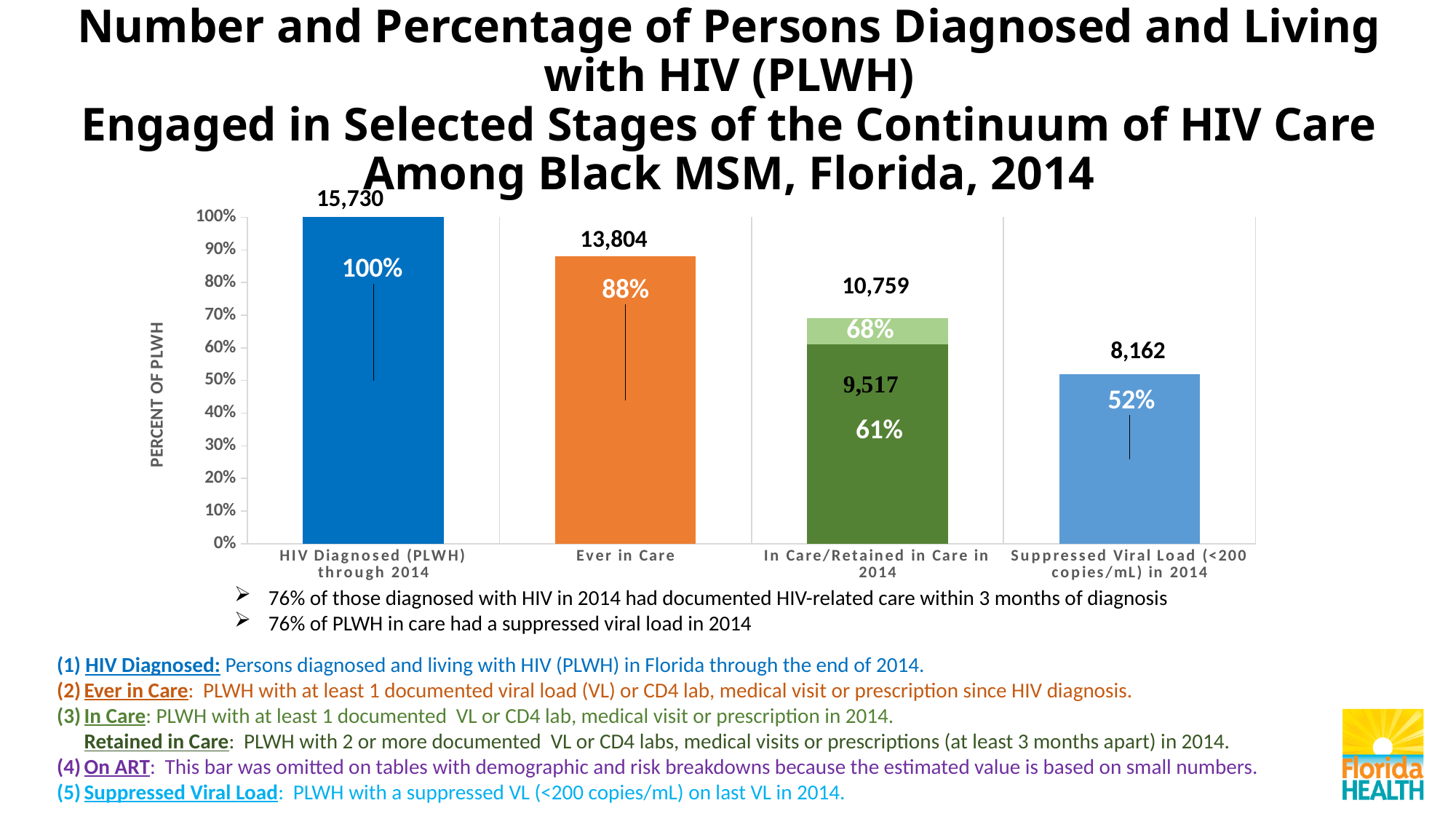
What number is labelled above the bar for HIV Diagnosed (PLWH) through 2014? 15,730 Do the bar values rise or fall from left to right along the x axis? fall What kind of chart is shown on the slide? bar chart What percentage is shown for Suppressed Viral Load (<200 copies/mL) in 2014? 52% What number is labelled above the In Care/Retained in Care in 2014 bar? 10,759 What percentage is shown for the Ever in Care bar? 88% Which category has the lowest bar? Suppressed Viral Load (<200 copies/mL) in 2014 What is the label on the vertical axis of the chart? PERCENT OF PLWH How many categories are shown on the x axis of the chart? 4 What is the difference in number between HIV Diagnosed (PLWH) through 2014 and Ever in Care? 1,926 Which category has the highest bar? HIV Diagnosed (PLWH) through 2014 What number is shown inside the dark green portion of the In Care/Retained in Care in 2014 bar? 9,517